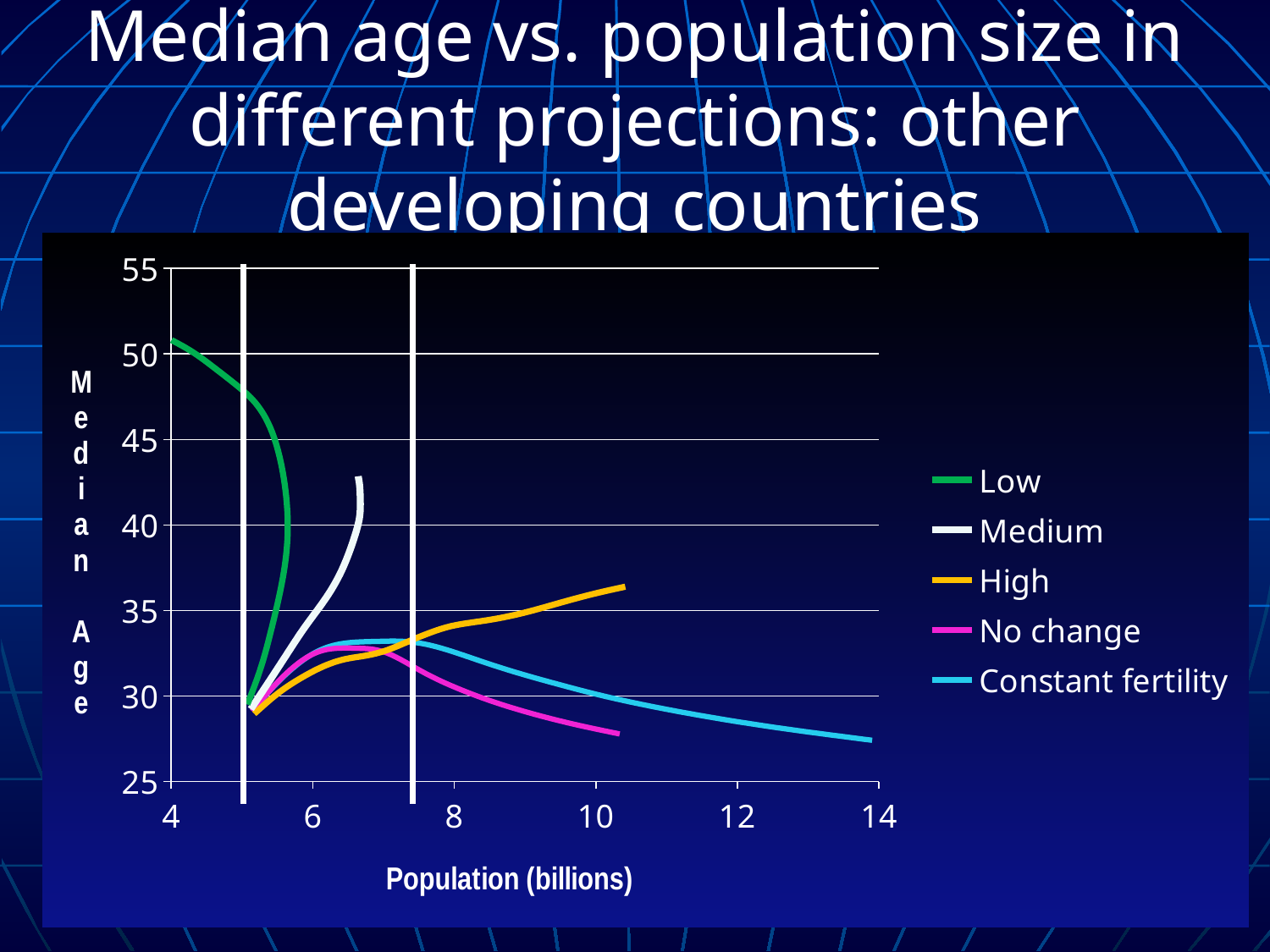
Is the highest median age reached by the Medium series greater or less than 40? greater Is the median age at the right-hand end of the No change line greater or less than 30? less What kind of chart is shown on the slide? line chart Is the median age at the right-hand end of the High line greater or less than 35? greater Does the median age for the High series rise or fall as population increases? rise Which colour is used for the Low series? green How many series does the legend list? 5 What is the title of the x axis? Population (billions) Beyond a population of 8 billion, does the median age for the Constant fertility series rise or fall as population increases? fall Which series reaches the highest median age on the chart? Low Which series extends to the largest population on the x axis? Constant fertility